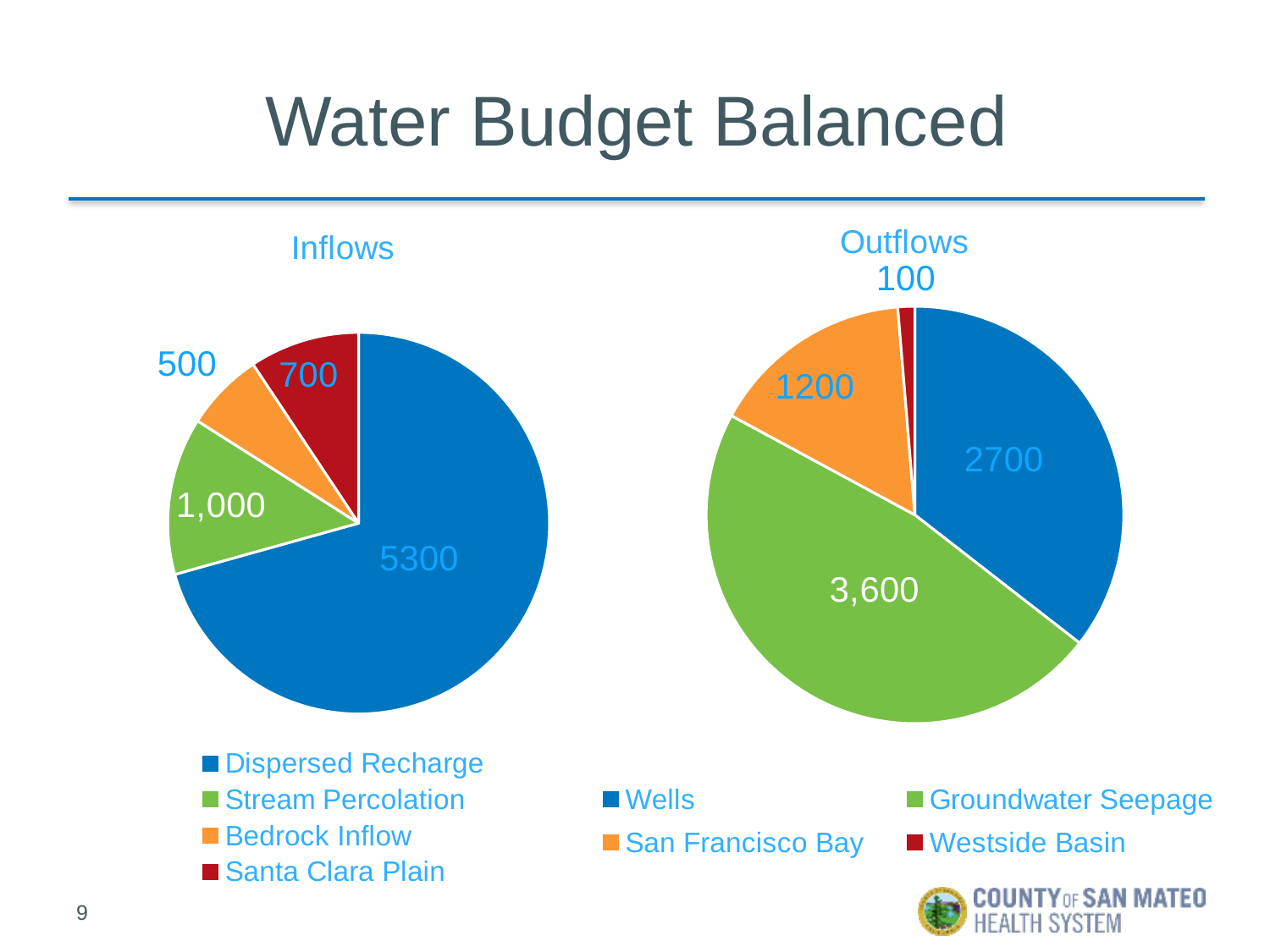
In the Inflows pie chart, what is the difference between Dispersed Recharge and Stream Percolation? 4300 In the Outflows pie chart, which category has the largest slice? Groundwater Seepage In the Outflows pie chart, what is the value for Groundwater Seepage? 3,600 In the Inflows pie chart, what is the value for Stream Percolation? 1,000 How many slices does the Inflows pie chart have? 4 What type of chart is used for Outflows? Pie chart In the Outflows pie chart, what is the total of all slices? 7600 In the Outflows pie chart, which is larger, Wells or San Francisco Bay? Wells In the Inflows pie chart, what is the value for Dispersed Recharge? 5300 In the Outflows pie chart, which category has the smallest slice? Westside Basin In the Outflows pie chart, what is the value for San Francisco Bay? 1200 In the Inflows pie chart, which category has the smallest slice? Bedrock Inflow